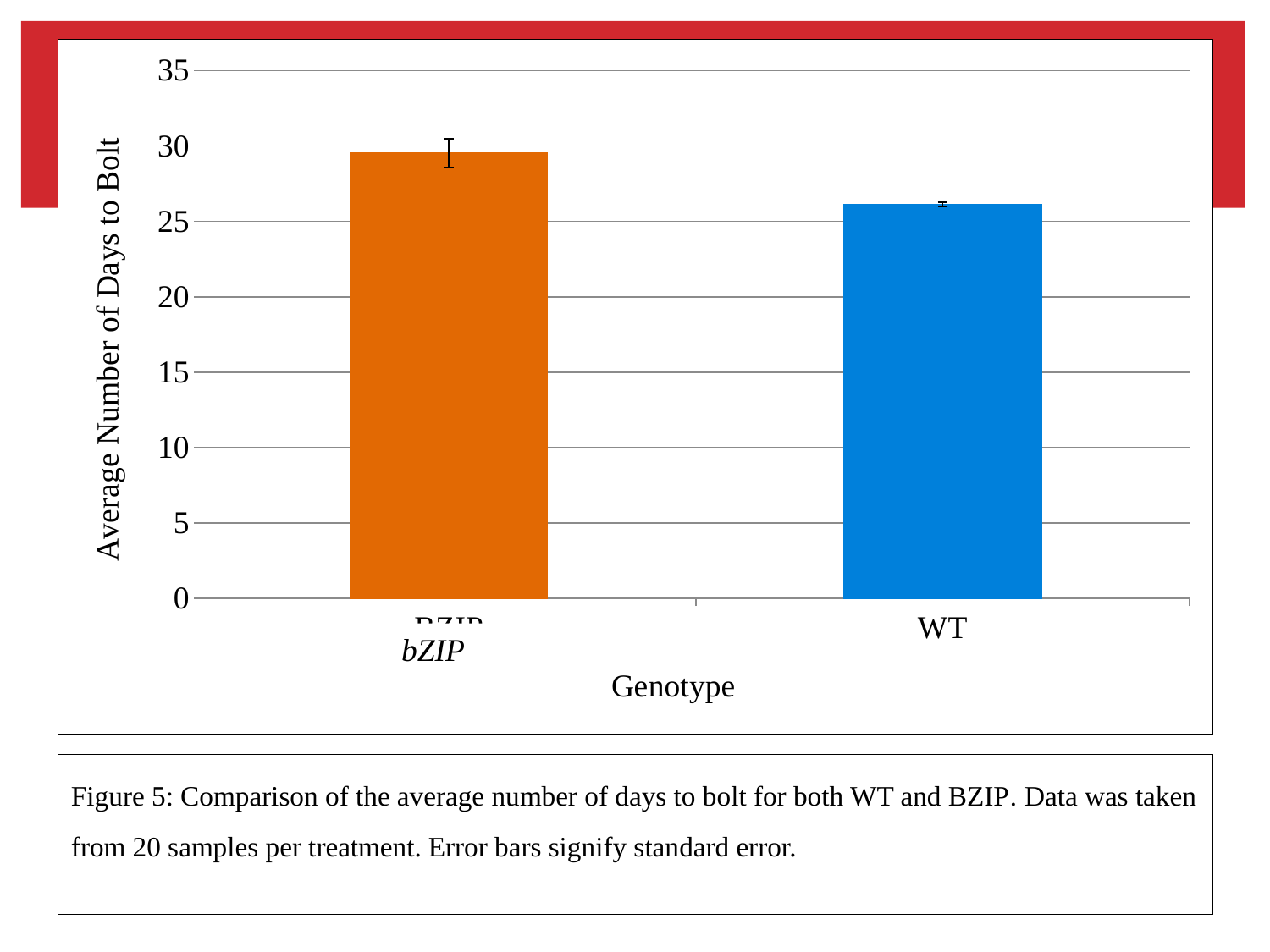
Which genotype has the lower average number of days to bolt? WT What kind of chart is shown on the slide? bar chart What is the title of the horizontal axis? Genotype Is the value for WT greater or less than 25? greater Which genotype has the higher average number of days to bolt? bZIP Is the value for WT greater or less than 30? less What is the title of the vertical axis? Average Number of Days to Bolt Is the value for bZIP greater or less than 35? less How many genotypes are plotted in the chart? 2 Which is larger, the average number of days to bolt for bZIP or for WT? bZIP